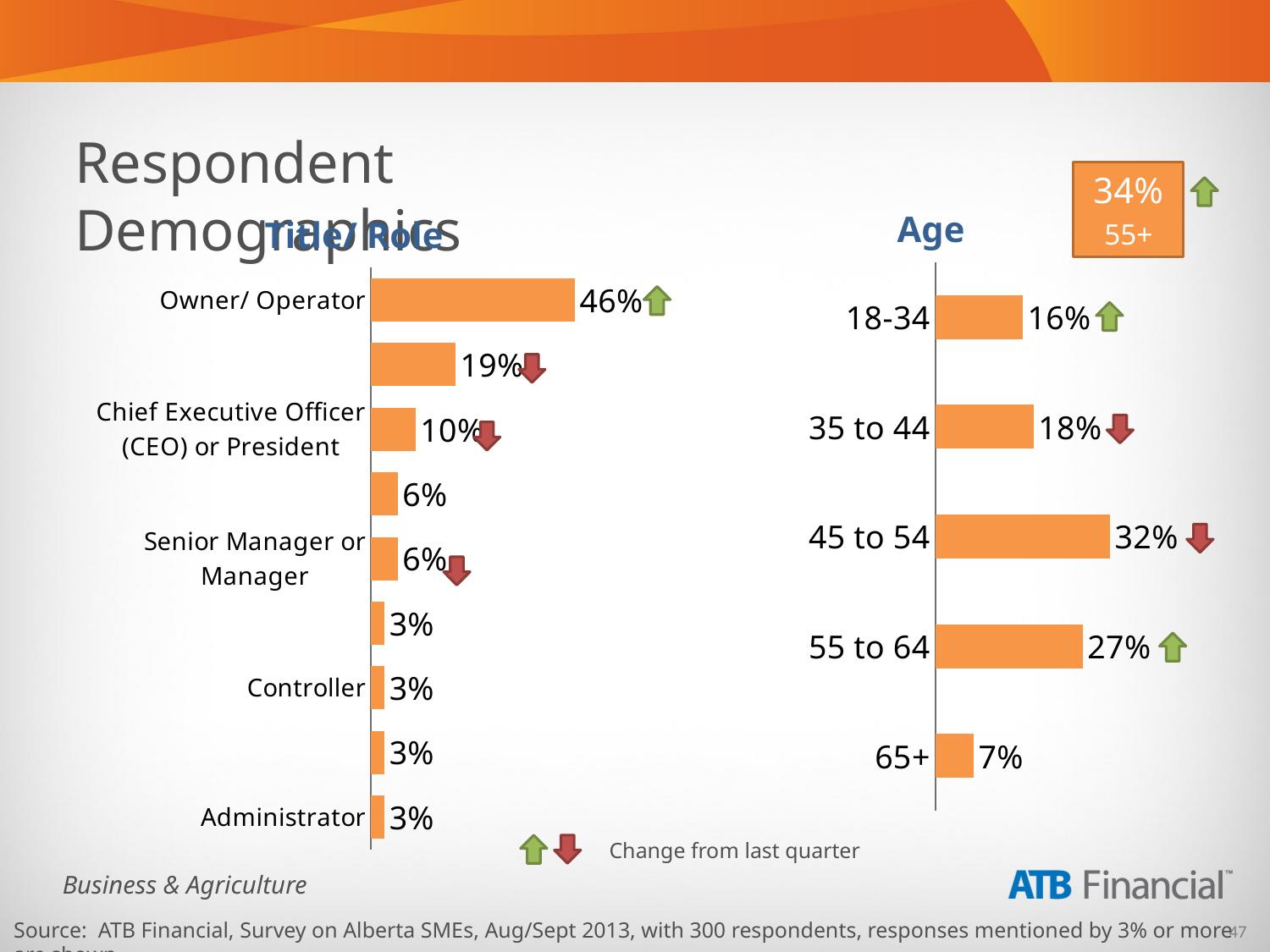
In the Age chart, which is larger, the value for 18-34 or the value for 35 to 44? 35 to 44 What type of chart is the Age chart? Bar chart In the Age chart, what is the value for the 65+ group? 7% In the Title/Role chart, which category has the highest value? Owner/ Operator In the Age chart, how many age groups are plotted? 5 In the Age chart, which age group has the highest value? 45 to 54 In the Age chart, which age group has the lowest value? 65+ In the Title/Role chart, what is the value for Owner/ Operator? 46% In the Title/Role chart, what is the difference between Owner/ Operator and Chief Executive Officer (CEO) or President? 36% In the Age chart, what is the value for the 45 to 54 group? 32% In the Age chart, what is the difference between the 45 to 54 group and the 55 to 64 group? 5% What percentage is shown in the callout box for respondents aged 55+ next to the Age chart? 34%